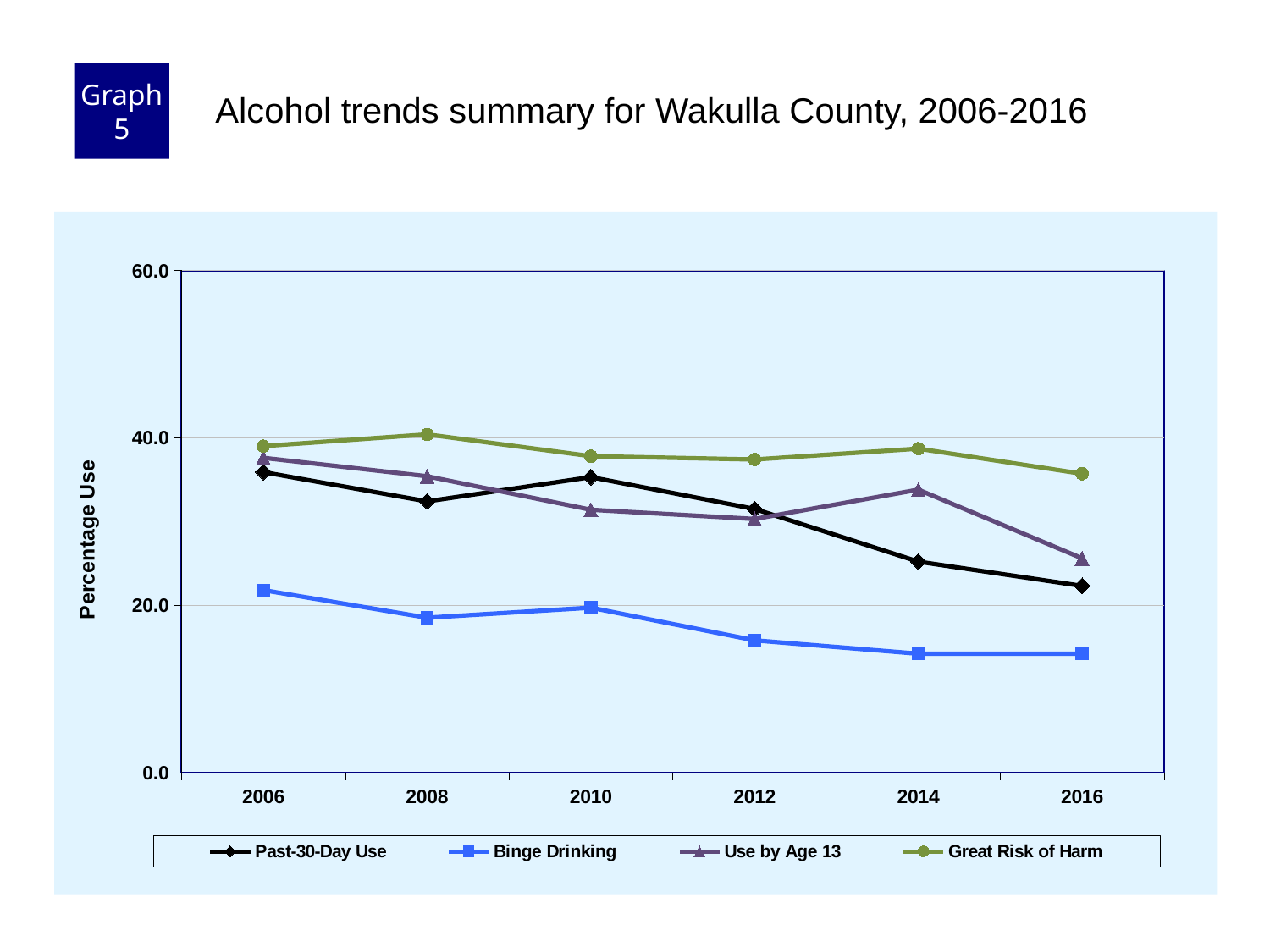
Does the Past-30-Day Use line rise or fall overall from 2006 to 2016? fall What is the label on the y axis? Percentage Use Which series has the highest value in 2016? Great Risk of Harm How many series does the legend list? 4 Is the value for Binge Drinking in 2016 greater or less than 20.0? less How many years are plotted along the x axis? 6 What kind of chart is shown on the slide? line chart In 2014, which is larger: Use by Age 13 or Past-30-Day Use? Use by Age 13 Is the value for Great Risk of Harm in 2016 greater or less than 40.0? less Is the value for Past-30-Day Use in 2006 greater or less than 40.0? less Which series has the lowest value in 2016? Binge Drinking Does the Binge Drinking line rise or fall overall from 2006 to 2016? fall